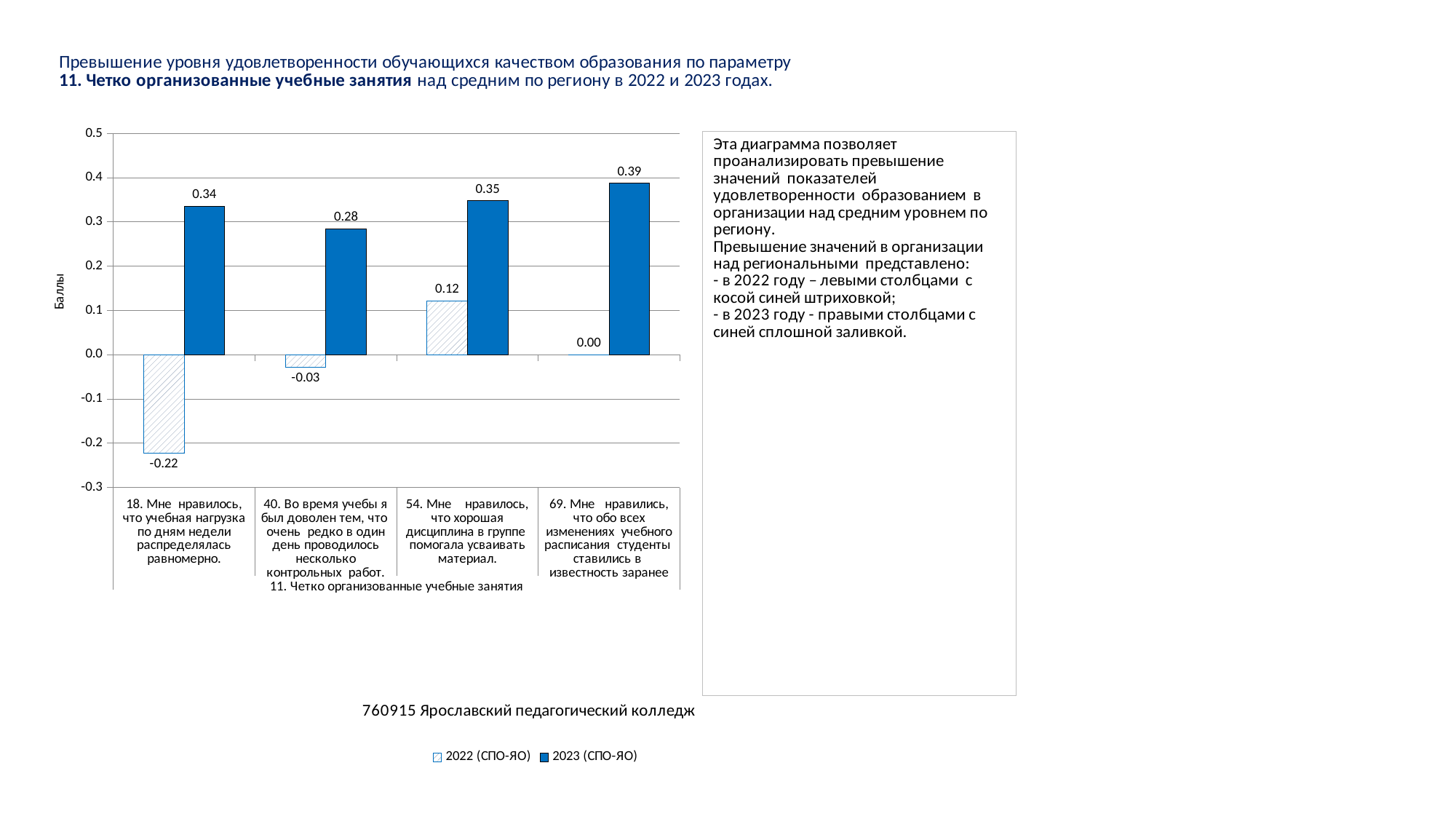
How many series does the chart legend list? 2 What type of chart is shown on the slide? Bar chart What is the value for 2023 (СПО-ЯО) for category 69 (Мне нравились, что обо всех изменениях учебного расписания студенты ставились в известность заранее)? 0.39 What is the value for 2023 (СПО-ЯО) for category 18 (Мне нравилось, что учебная нагрузка по дням недели распределялась равномерно)? 0.34 Which category has the lowest value for the 2022 (СПО-ЯО) series? 18. Мне нравилось, что учебная нагрузка по дням недели распределялась равномерно. What is the label of the vertical axis of the chart? Баллы Which category has the highest value for the 2023 (СПО-ЯО) series? 69. Мне нравились, что обо всех изменениях учебного расписания студенты ставились в известность заранее How many categories are shown on the x axis of the chart? 4 What is the value for 2022 (СПО-ЯО) for category 18 (Мне нравилось, что учебная нагрузка по дням недели распределялась равномерно)? -0.22 Which is larger for category 54: the 2022 (СПО-ЯО) value or the 2023 (СПО-ЯО) value? 2023 (СПО-ЯО) What is the value for 2022 (СПО-ЯО) for category 54 (Мне нравилось, что хорошая дисциплина в группе помогала усваивать материал)? 0.12 What is the difference between the 2023 and 2022 values for category 40 (Во время учебы я был доволен тем, что очень редко в один день проводилось несколько контрольных работ)? 0.31